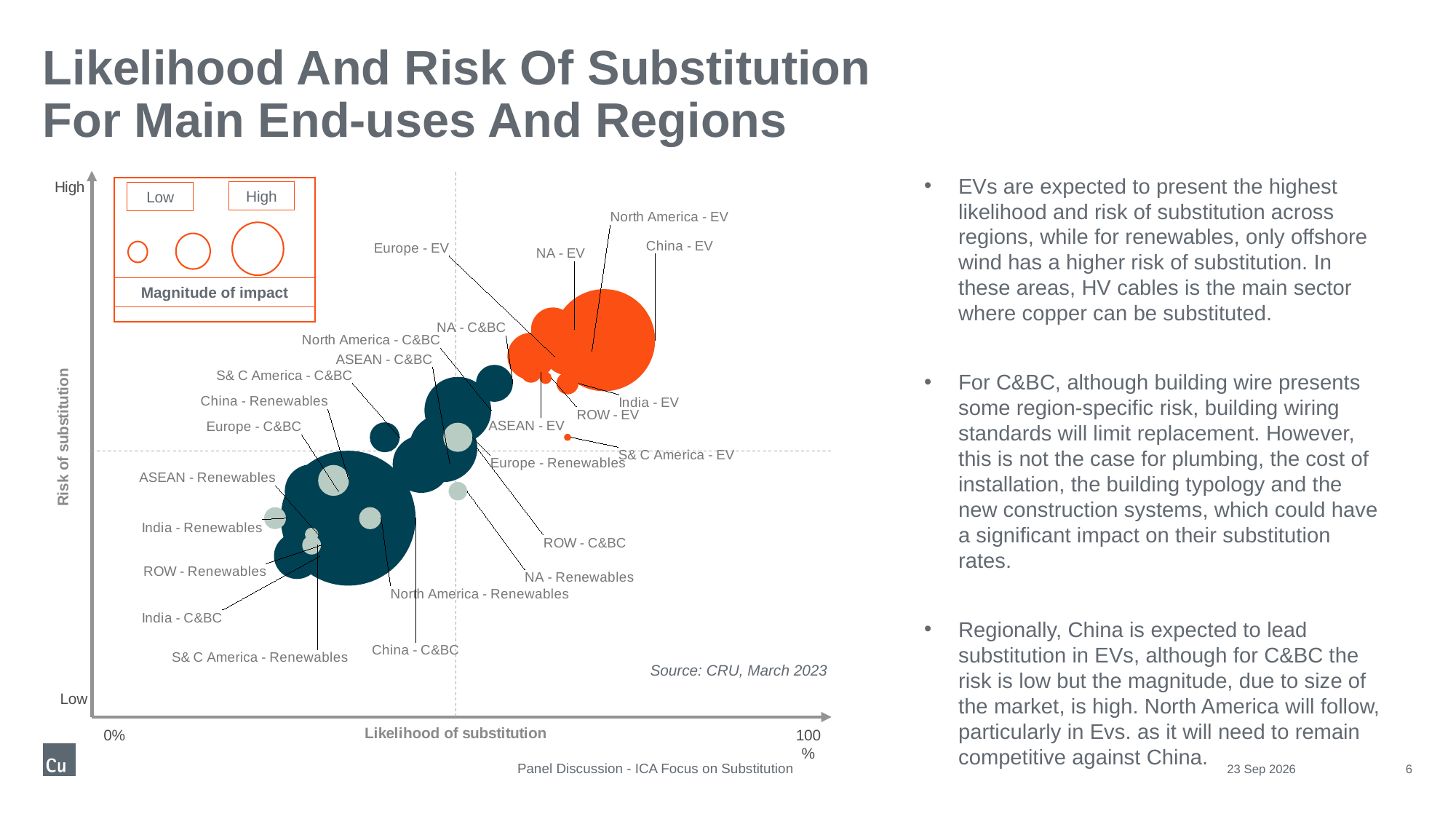
Which end-use group is plotted in orange (the 'High' colour) on the chart? EV As likelihood of substitution increases along the x axis, does risk of substitution generally rise or fall? Rise Which has a higher likelihood of substitution, China - EV or India - C&BC? China - EV How many labelled bubbles are plotted on the chart? 24 Which has a higher risk of substitution, North America - EV or S& C America - Renewables? North America - EV What is the label of the vertical axis of the chart? Risk of substitution What is the source cited for the chart? CRU, March 2023 What is the label of the horizontal axis of the chart? Likelihood of substitution Which labelled bubble is the smallest on the chart? S& C America - EV What kind of chart is shown on the slide? Bubble chart